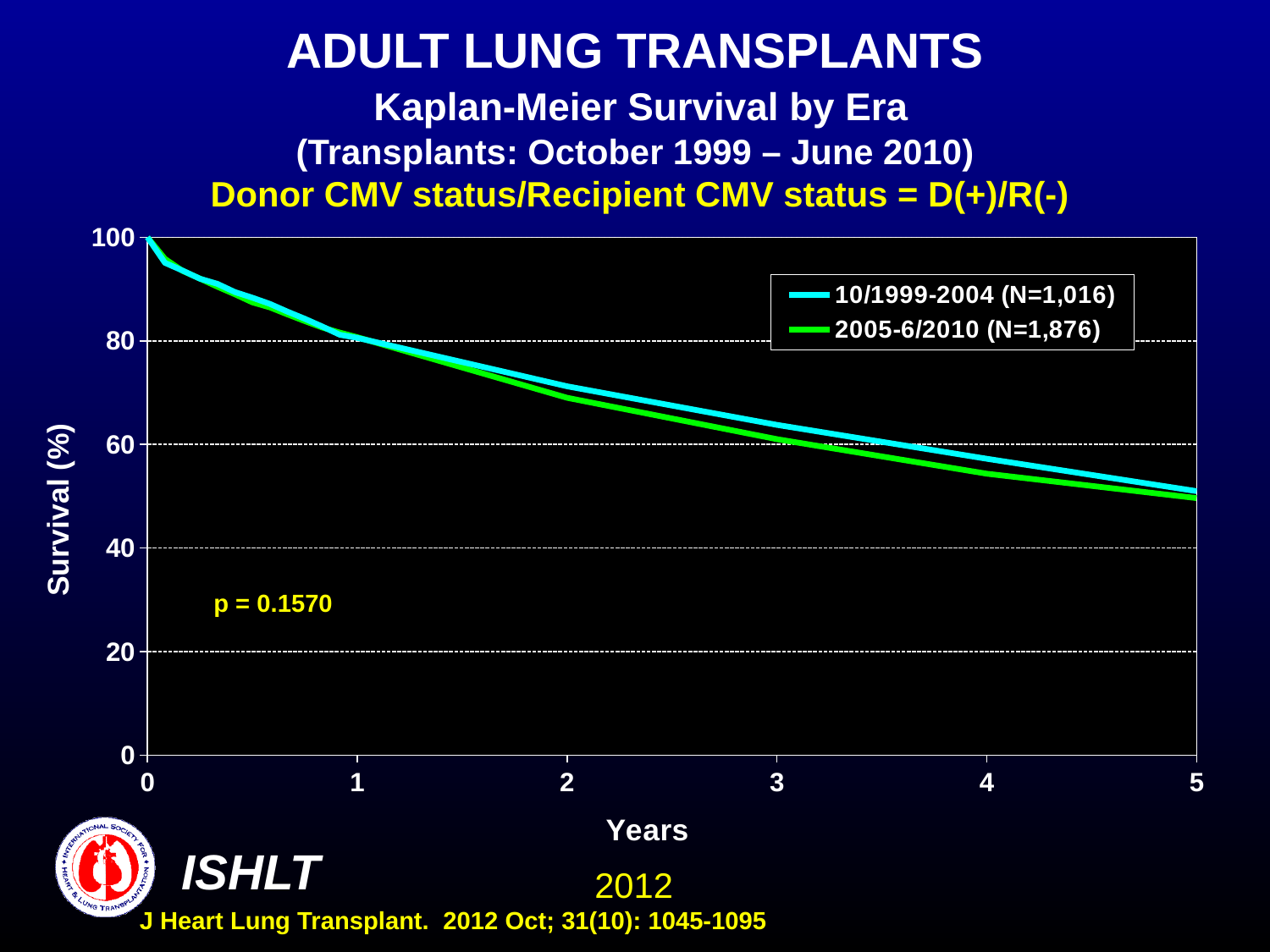
What is the highest value shown on the y axis? 100 What is the label of the y axis? Survival (%) What is the N for the 2005-6/2010 era shown in the legend? N=1,876 How many series does the legend list? 2 Is the survival for the 2005-6/2010 era at 5 years greater or less than 40? greater Is the survival for the 10/1999-2004 era at 3 years greater or less than 60? greater Is the survival for the 2005-6/2010 era at 2 years greater or less than 80? less Do the survival curves rise or fall as the years increase? fall What is the p-value printed on the chart? p = 0.1570 What kind of chart is shown on the slide? line chart What is the N for the 10/1999-2004 era shown in the legend? N=1,016